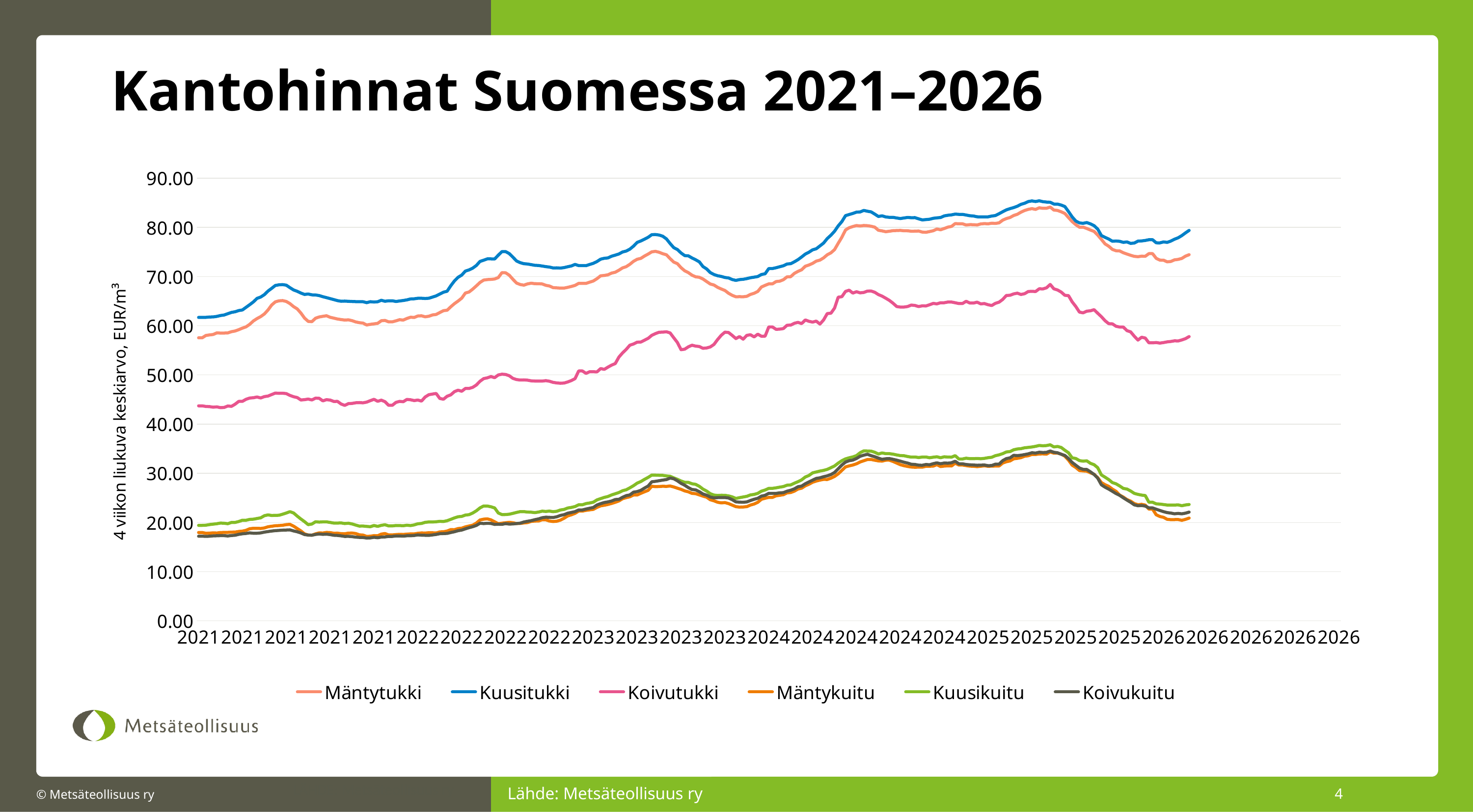
What kind of chart is shown on the slide? line chart Which is higher throughout the chart, Koivutukki or Kuusikuitu? Koivutukki Is the value of Koivutukki at the start of 2021 greater or less than 50? less Which series has the highest values across the whole chart? Kuusitukki Is the peak value of Kuusitukki in 2025 greater or less than 80? greater Which is higher throughout the chart, Kuusitukki or Mäntytukki? Kuusitukki How many series does the legend list? 6 What is the title of the chart? Kantohinnat Suomessa 2021–2026 Is the value of Mäntytukki at the start of 2021 greater or less than 60? less What is the label of the vertical axis? 4 viikon liukuva keskiarvo, EUR/m³ Does the Koivutukki series generally rise or fall from 2021 to 2025? rise